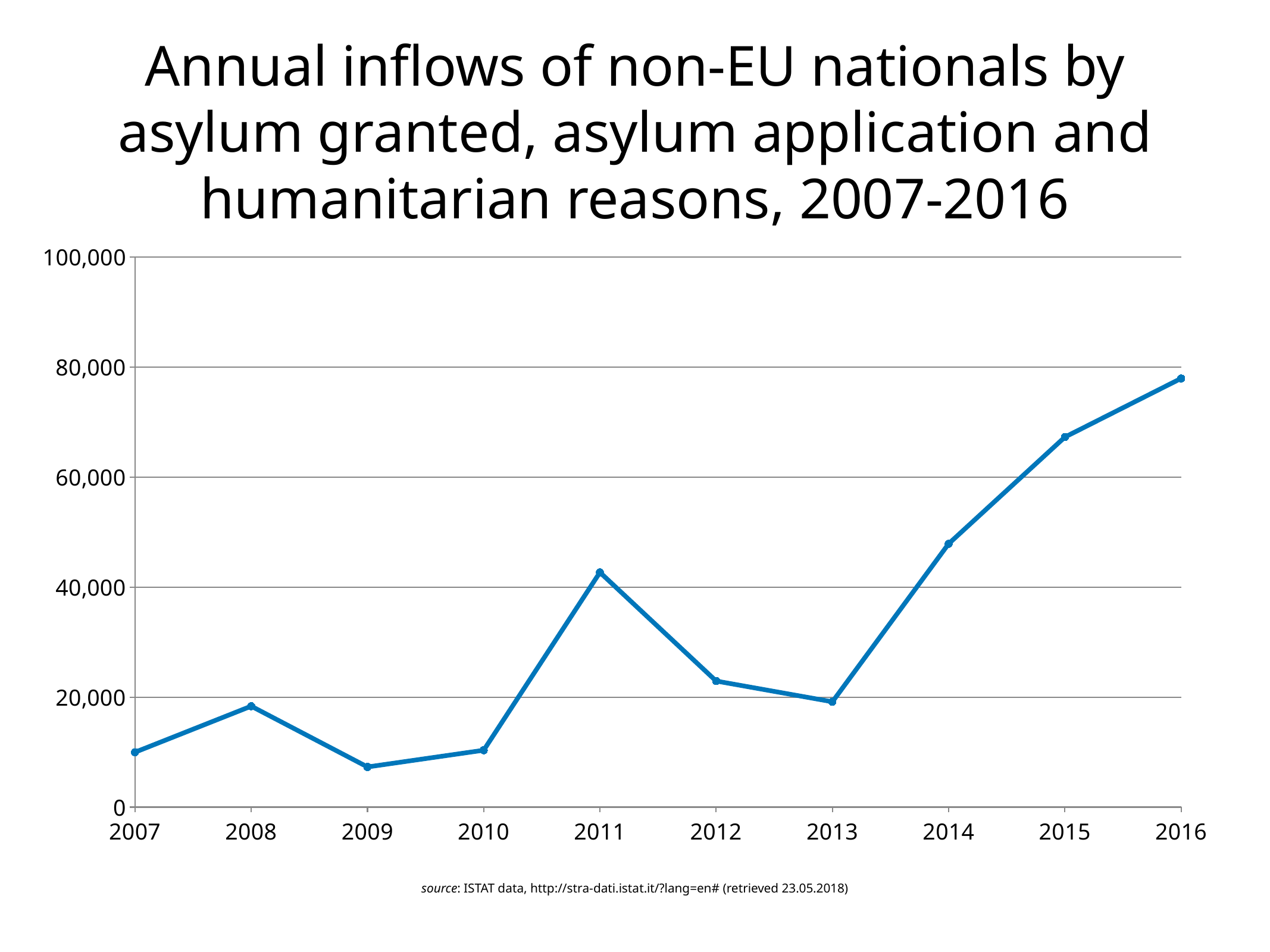
Do the values rise or fall from 2013 to 2016? Rise Is the value for 2007 greater or less than 20,000? less What kind of chart is shown on the slide? Line chart Is the value for 2014 greater or less than 40,000? greater How many years (data points) are plotted on the chart? 10 What is the source of the data cited below the chart? ISTAT data Is the value for 2016 greater or less than 60,000? greater Which year has the larger inflow, 2011 or 2012? 2011 Which year has the larger inflow, 2015 or 2014? 2015 Which year has the lowest annual inflow? 2009 Which year has the highest annual inflow? 2016